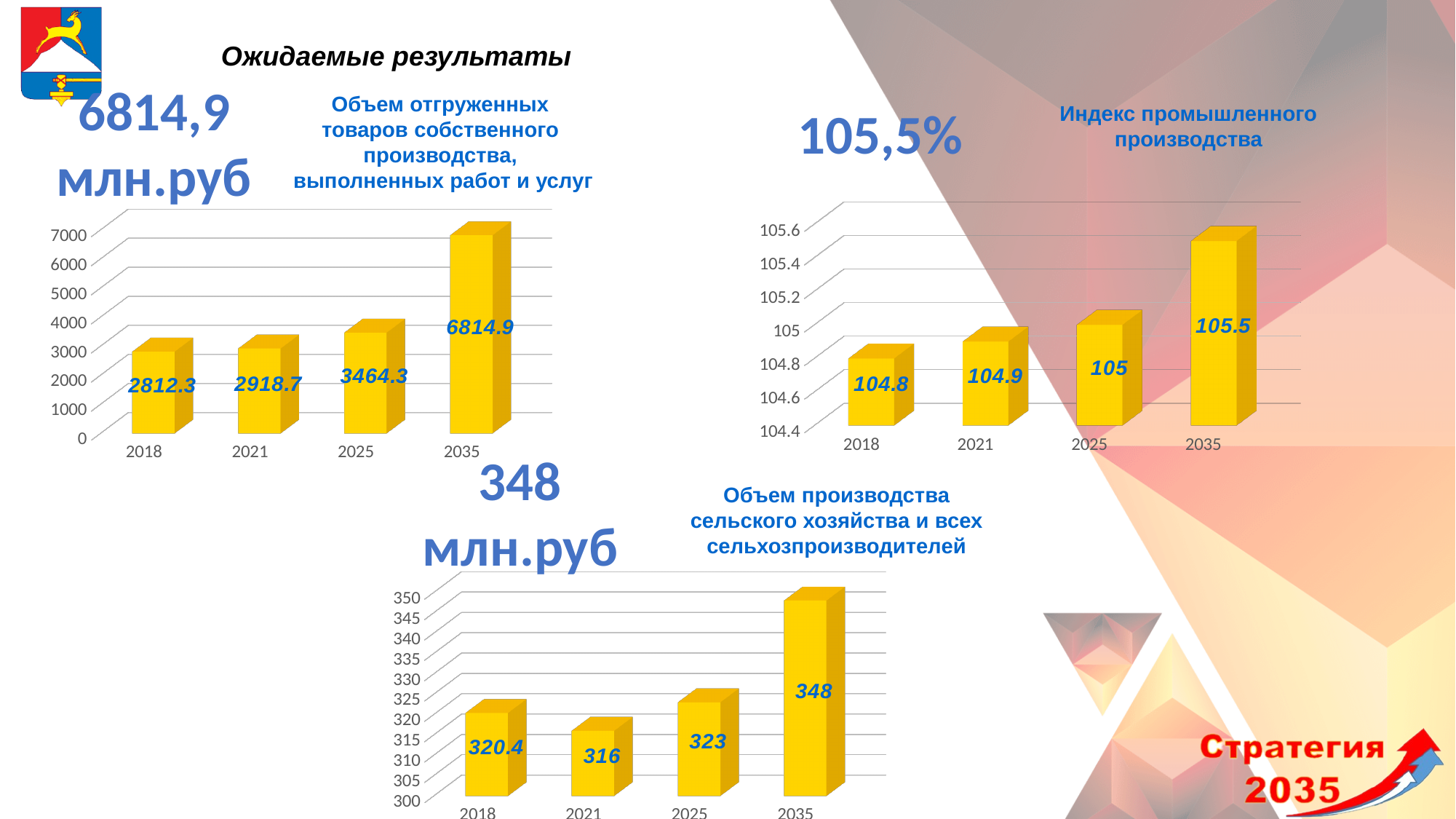
In the bottom chart (Объем производства сельского хозяйства), what is the value for 2021? 316 In the top-right chart (Индекс промышленного производства), which year has the lowest value? 2018 In the top-left chart (Объем отгруженных товаров), how many years are plotted? 4 In the top-right chart (Индекс промышленного производства), do the values rise or fall from 2018 to 2035? rise In the bottom chart (Объем производства сельского хозяйства), which is larger, the value for 2018 or the value for 2025? 2025 In the top-left chart (Объем отгруженных товаров собственного производства, выполненных работ и услуг), what is the value for 2025? 3464.3 In the bottom chart (Объем производства сельского хозяйства), what is the difference between the 2035 and 2025 values? 25 In the bottom chart (Объем производства сельского хозяйства), which year has the lowest value? 2021 In the top-left chart (Объем отгруженных товаров), what is the difference between the 2035 and 2018 values? 4002.6 In the top-left chart (Объем отгруженных товаров), which year has the highest value? 2035 In the top-right chart (Индекс промышленного производства), what is the value for 2021? 104.9 What type of chart is the bottom chart (Объем производства сельского хозяйства)? bar chart